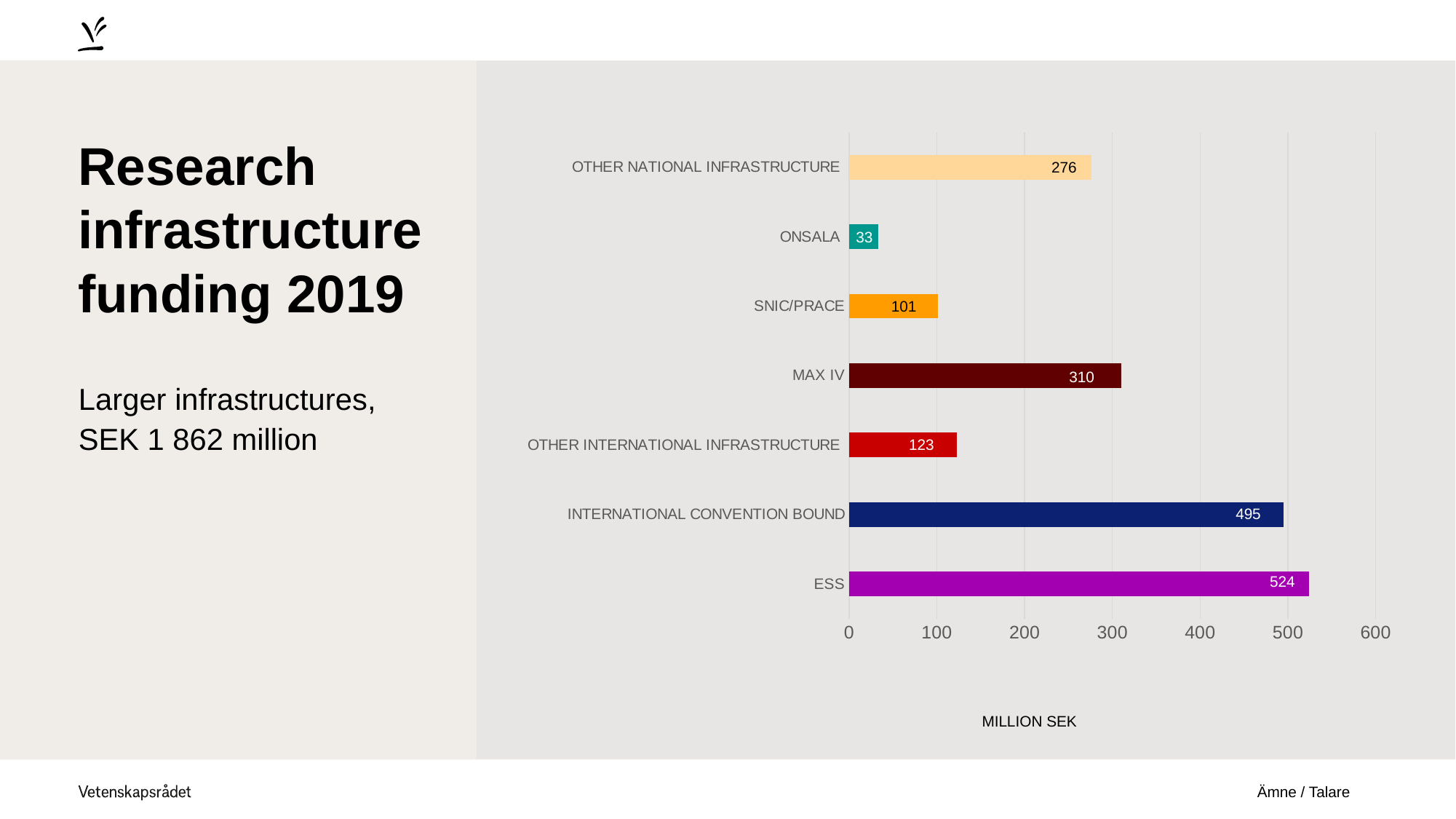
What is the difference between the values for MAX IV and SNIC/PRACE? 209 Which category has the lowest value? ONSALA Which category has the highest value? ESS Which is larger, the value for OTHER INTERNATIONAL INFRASTRUCTURE or the value for SNIC/PRACE? OTHER INTERNATIONAL INFRASTRUCTURE What kind of chart is shown on the slide? Bar chart What is the difference between the values for ESS and INTERNATIONAL CONVENTION BOUND? 29 What is the value for ONSALA? 33 What is the value for ESS? 524 What is the value for MAX IV? 310 What is the value for OTHER NATIONAL INFRASTRUCTURE? 276 How many categories are shown in the chart? 7 What unit is given on the x axis label of the chart? MILLION SEK